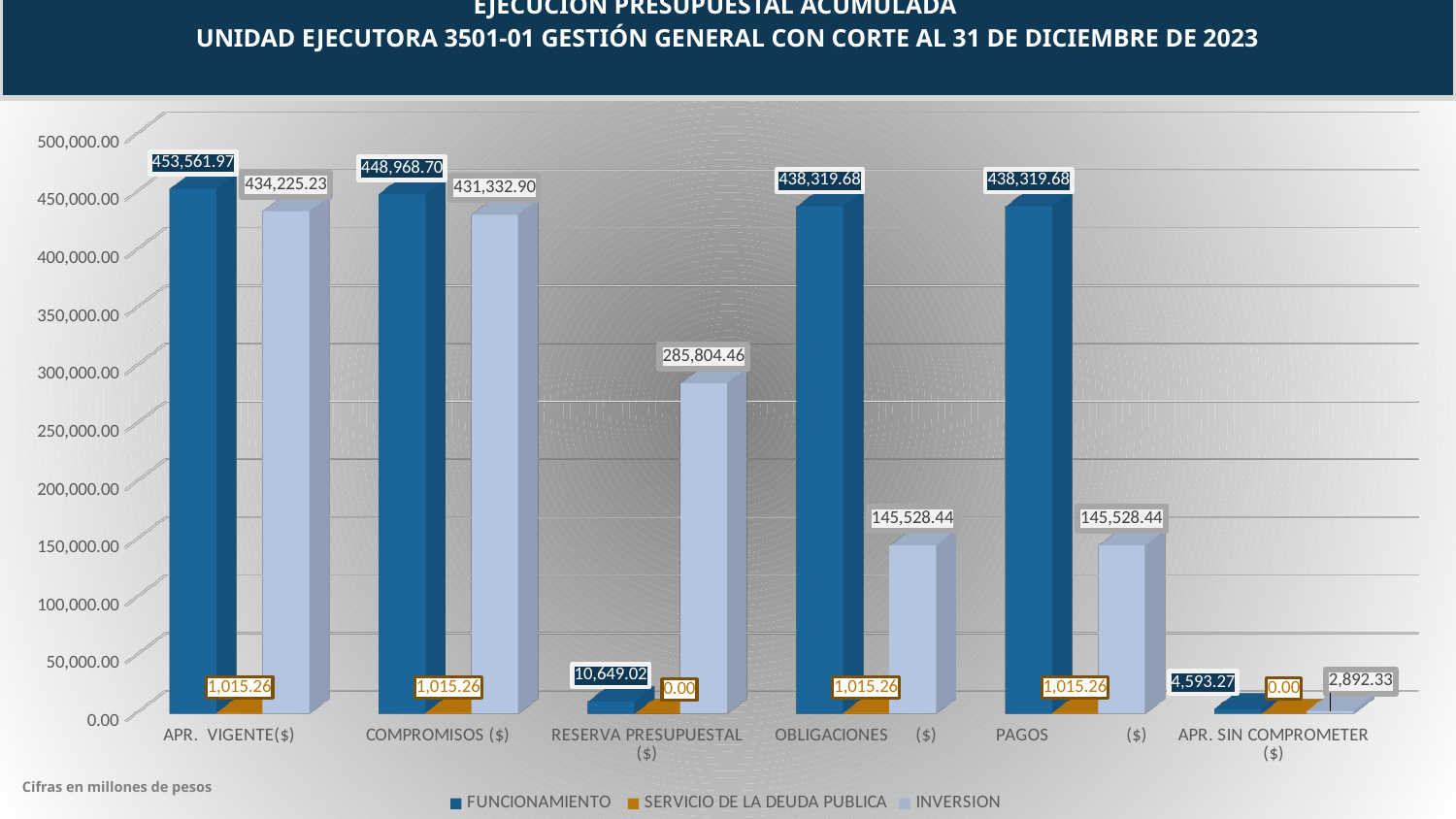
Which category has the highest FUNCIONAMIENTO value? APR. VIGENTE($) Is the INVERSION value for OBLIGACIONES ($) greater or less than 200,000.00? less Which category has the lowest INVERSION value? APR. SIN COMPROMETER ($) What is the SERVICIO DE LA DEUDA PUBLICA value for COMPROMISOS ($)? 1,015.26 What is the INVERSION value for RESERVA PRESUPUESTAL ($)? 285,804.46 What is the FUNCIONAMIENTO value for APR. VIGENTE($)? 453,561.97 What is the INVERSION value for APR. SIN COMPROMETER ($)? 2,892.33 How many series does the legend list? 3 Which is larger for RESERVA PRESUPUESTAL ($): the FUNCIONAMIENTO value or the INVERSION value? INVERSION How many categories are shown on the x axis? 6 What kind of chart is shown on the slide? bar chart What is the difference between the FUNCIONAMIENTO values for APR. VIGENTE($) and COMPROMISOS ($)? 4,593.27